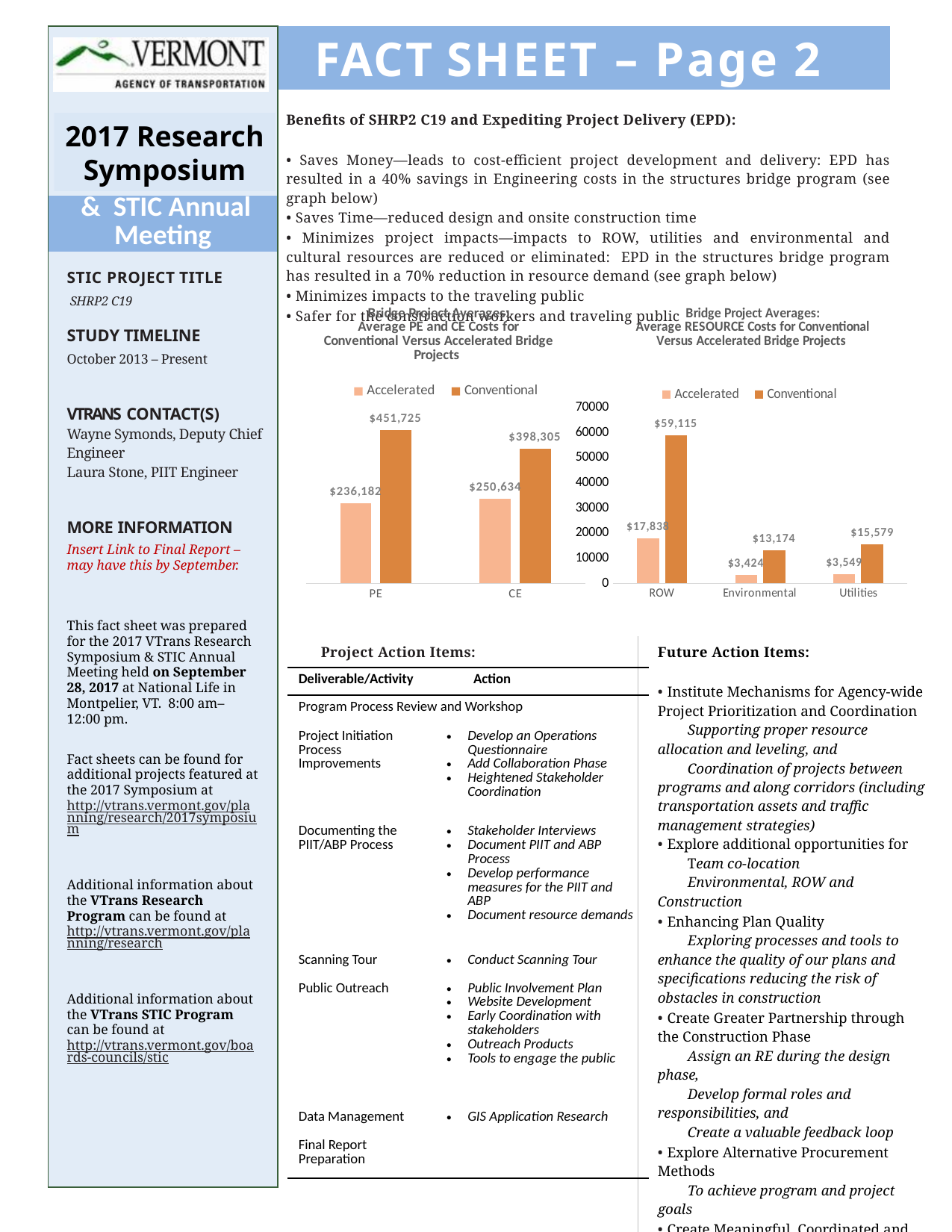
In the right chart (Average RESOURCE Costs), how many categories are shown on the x axis? 3 In the left chart (Average PE and CE Costs), how many series does the legend list? 2 In the right chart (Average RESOURCE Costs), which category has the highest Conventional value? ROW What type of chart is the right chart (Average RESOURCE Costs)? Bar chart In the left chart (Average PE and CE Costs), what is the Accelerated value for CE? $250,634 In the right chart (Average RESOURCE Costs), what is the Conventional value for ROW? $59,115 In the left chart (Average PE and CE Costs), what is the Conventional value for PE? $451,725 In the left chart (Average PE and CE Costs), which series has the higher value for CE, Accelerated or Conventional? Conventional In the right chart (Average RESOURCE Costs), what is the Accelerated value for Environmental? $3,424 In the left chart (Average PE and CE Costs), what is the difference between the Conventional and Accelerated values for PE? $215,543 In the right chart (Average RESOURCE Costs), which category has the lowest Accelerated value? Environmental In the right chart (Average RESOURCE Costs), what is the difference between the Conventional and Accelerated values for Utilities? $12,030